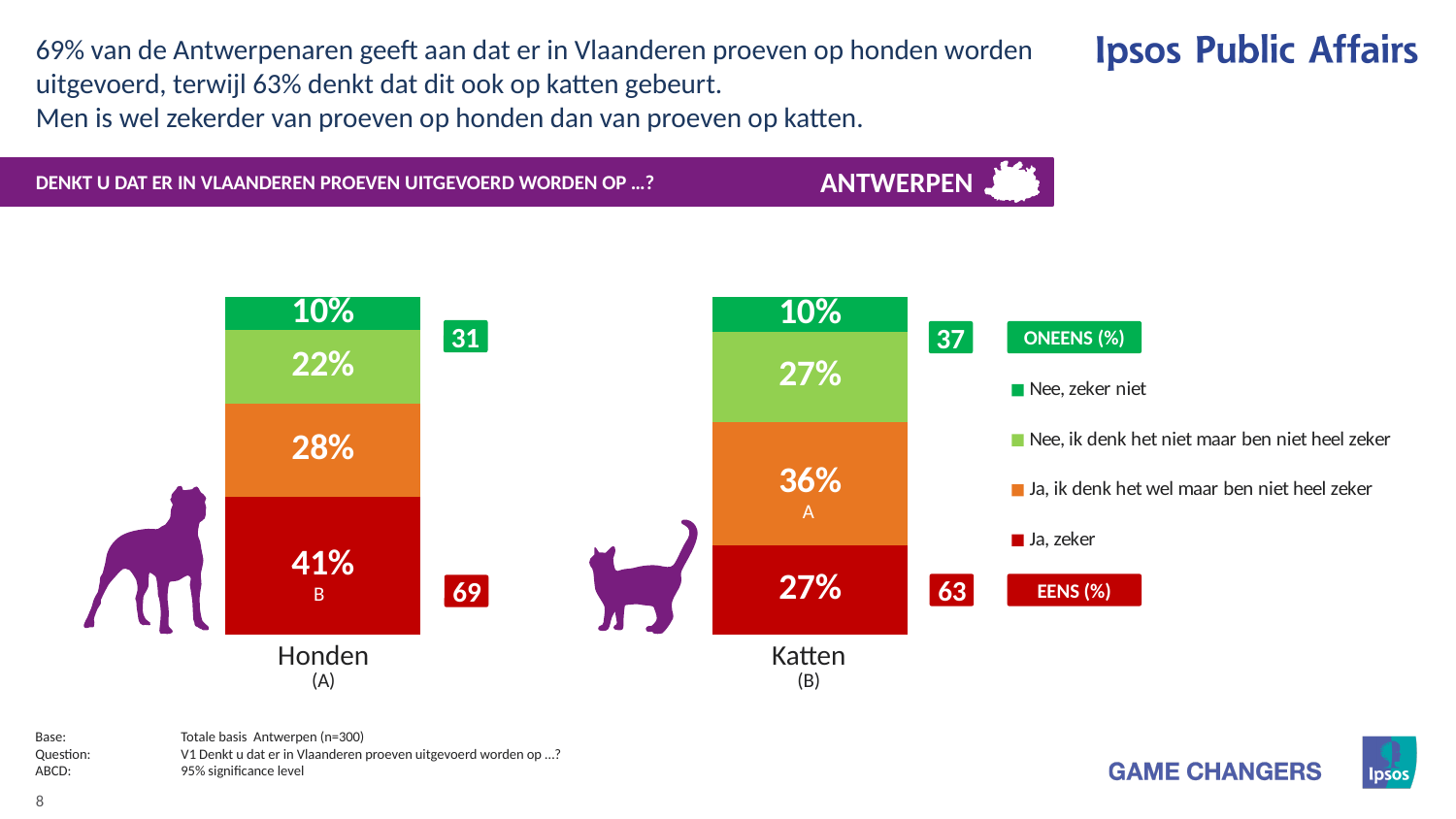
How many categories are shown on the x axis? 2 What is the EENS (%) total shown for Katten? 63 What is the difference between the EENS (%) totals for Honden and Katten? 6 How many series does the legend list? 4 What is the ONEENS (%) total shown for Honden? 31 What percentage of respondents answered "Ja, zeker" for Honden? 41% What is the difference between the "Ja, zeker" percentages for Honden and Katten? 14% Which legend entry is shown in red? Ja, zeker What kind of chart is shown on the slide? Stacked bar chart Which category has the higher "Ja, zeker" share, Honden or Katten? Honden What percentage of respondents answered "Nee, ik denk het niet maar ben niet heel zeker" for Honden? 22% What percentage of respondents answered "Ja, ik denk het wel maar ben niet heel zeker" for Katten? 36%